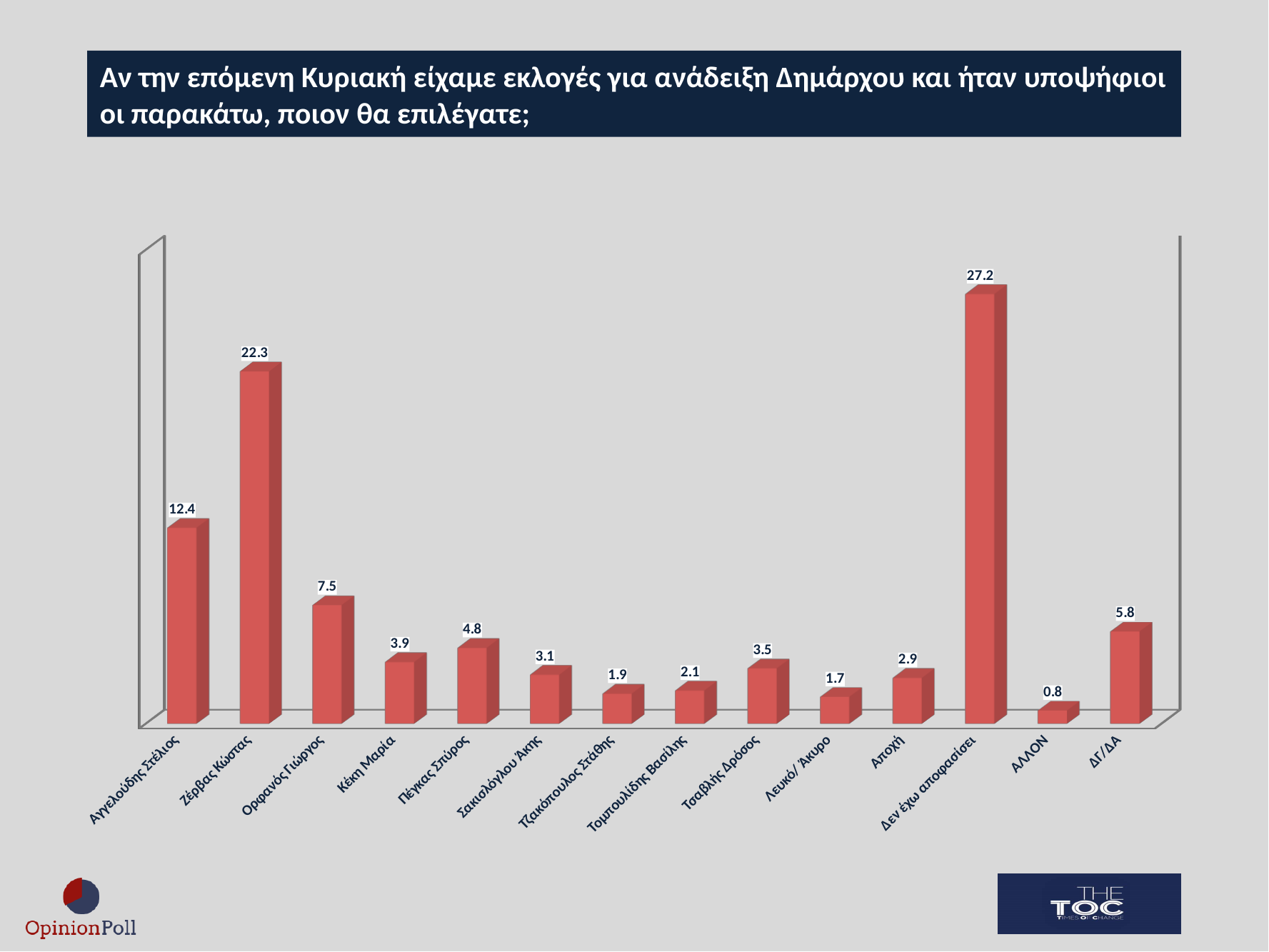
Which is larger, the value for Πέγκας Σπύρος or the value for Κέκη Μαρία? Πέγκας Σπύρος What is the difference between the values for Δεν έχω αποφασίσει and Ζέρβας Κώστας? 4.9 What kind of chart is shown on the slide? Bar chart Which category has the lowest value? ΑΛΛΟΝ What value is shown for ΔΓ/ΔΑ? 5.8 Which category has the highest value? Δεν έχω αποφασίσει What value is shown for Αγγελούδης Στέλιος? 12.4 Which candidate among the named individuals has the highest value? Ζέρβας Κώστας What value is shown for Ορφανός Γιώργος? 7.5 What is the difference between the values for Ζέρβας Κώστας and Αγγελούδης Στέλιος? 9.9 What value is shown for Ζέρβας Κώστας? 22.3 How many categories are shown on the chart? 14